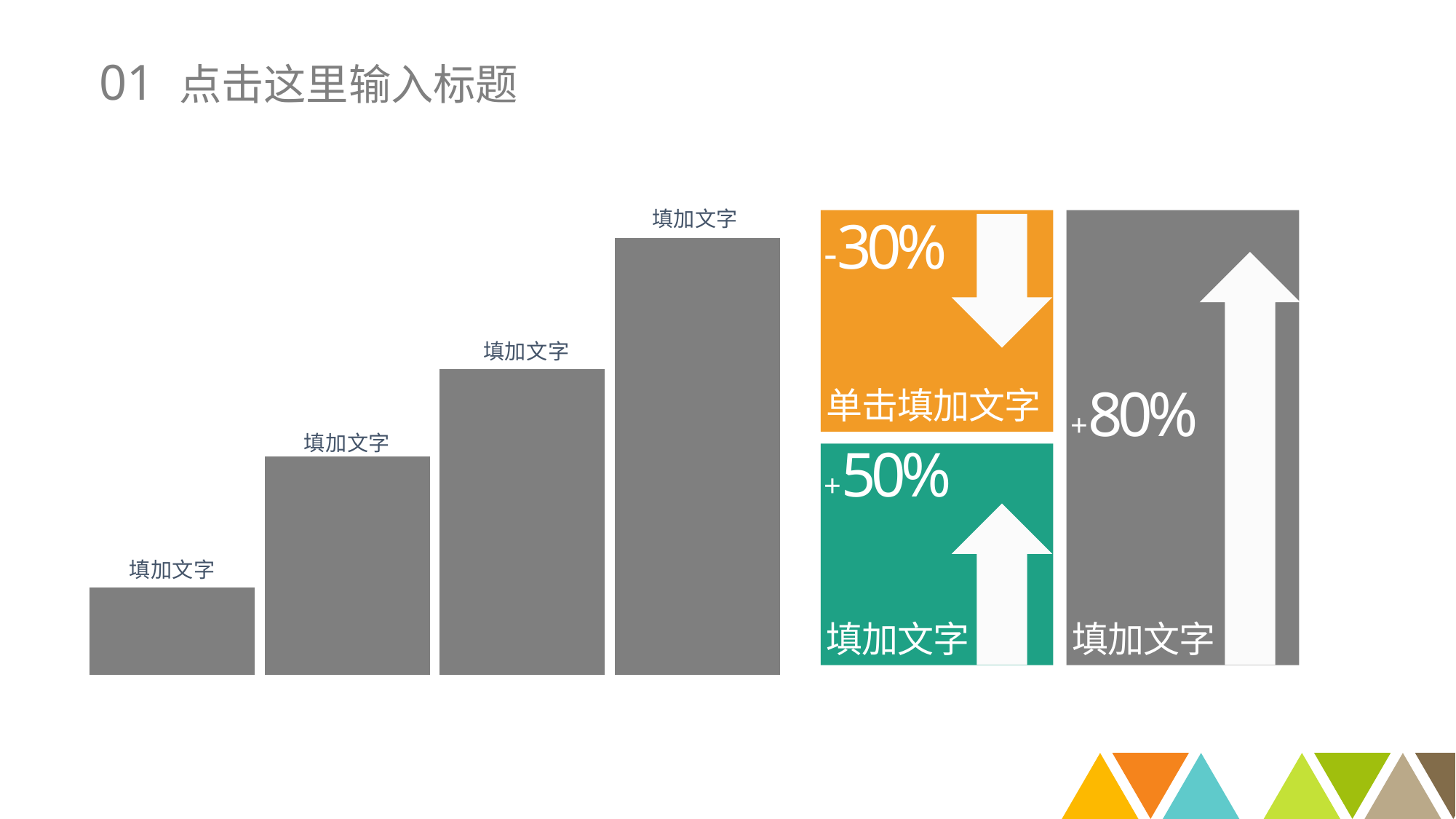
In the bar chart, which is taller, the leftmost bar or the rightmost bar? the rightmost bar Which bar in the bar chart is the shortest? the leftmost bar What colour are the bars in the bar chart? gray How many bars does the bar chart have? 4 In the bar chart, which is taller, the second bar from the left or the third bar from the left? the third bar from the left What text label appears above each bar in the bar chart? 填加文字 Which bar in the bar chart is the tallest? the rightmost bar What kind of chart is shown on the left of the slide? bar chart Do the bars in the bar chart rise or fall from left to right? rise